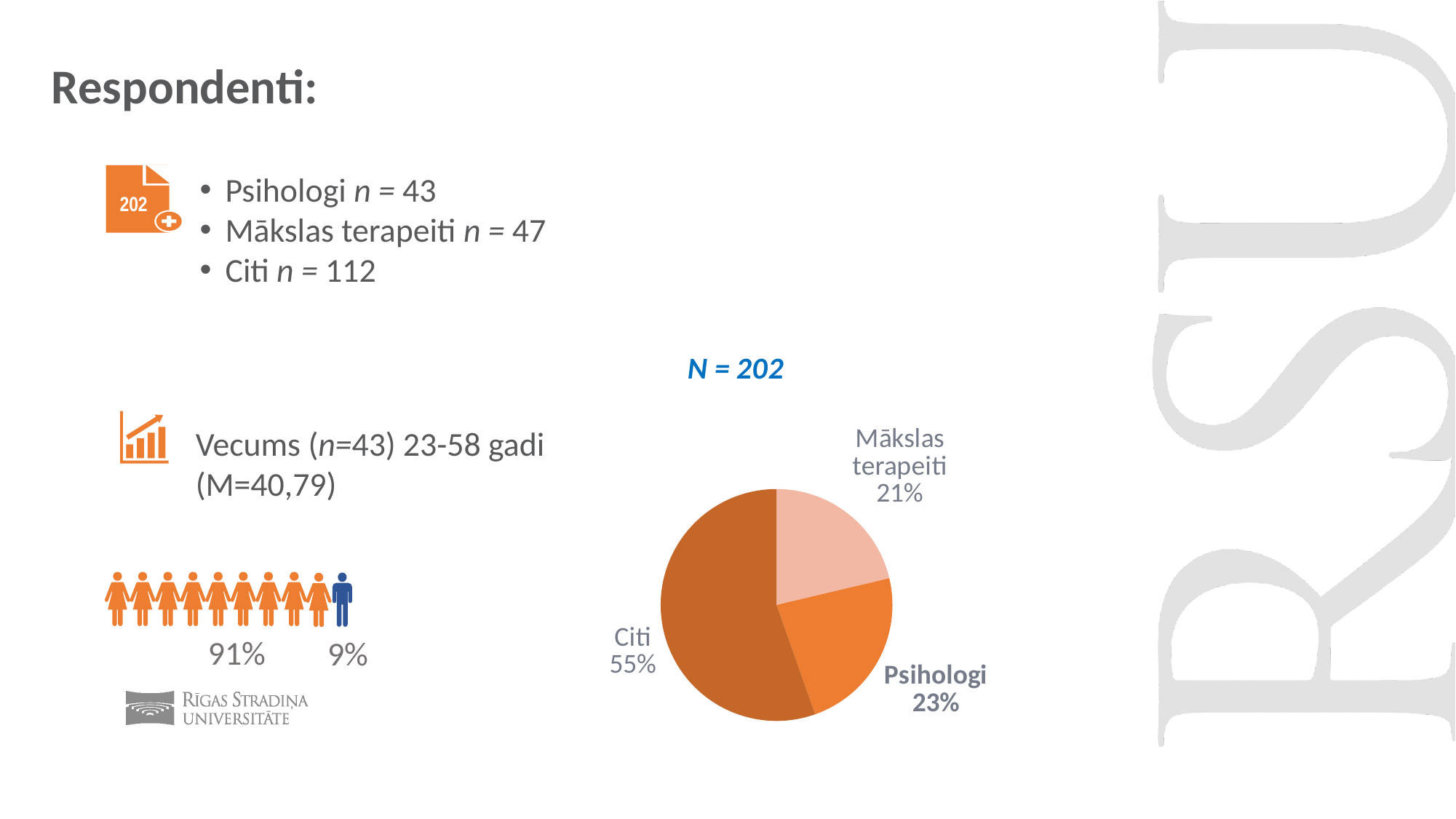
Which slice of the pie chart is drawn in the lightest shade of orange? Mākslas terapeiti What share of the pie chart does the Citi slice represent? 55% Is the Citi slice greater or less than 50% of the pie chart? greater What share of the pie chart does the Psihologi slice represent? 23% What share of the pie chart does the Mākslas terapeiti slice represent? 21% What is the difference in percentage points between the Psihologi slice and the Mākslas terapeiti slice? 2 Which slice of the pie chart is the smallest? Mākslas terapeiti What kind of chart is shown on the slide? pie chart How many slices does the pie chart have? 3 What is the difference in percentage points between the Citi slice and the Psihologi slice? 32 Which slice of the pie chart is the largest? Citi What is the title shown above the pie chart? N = 202